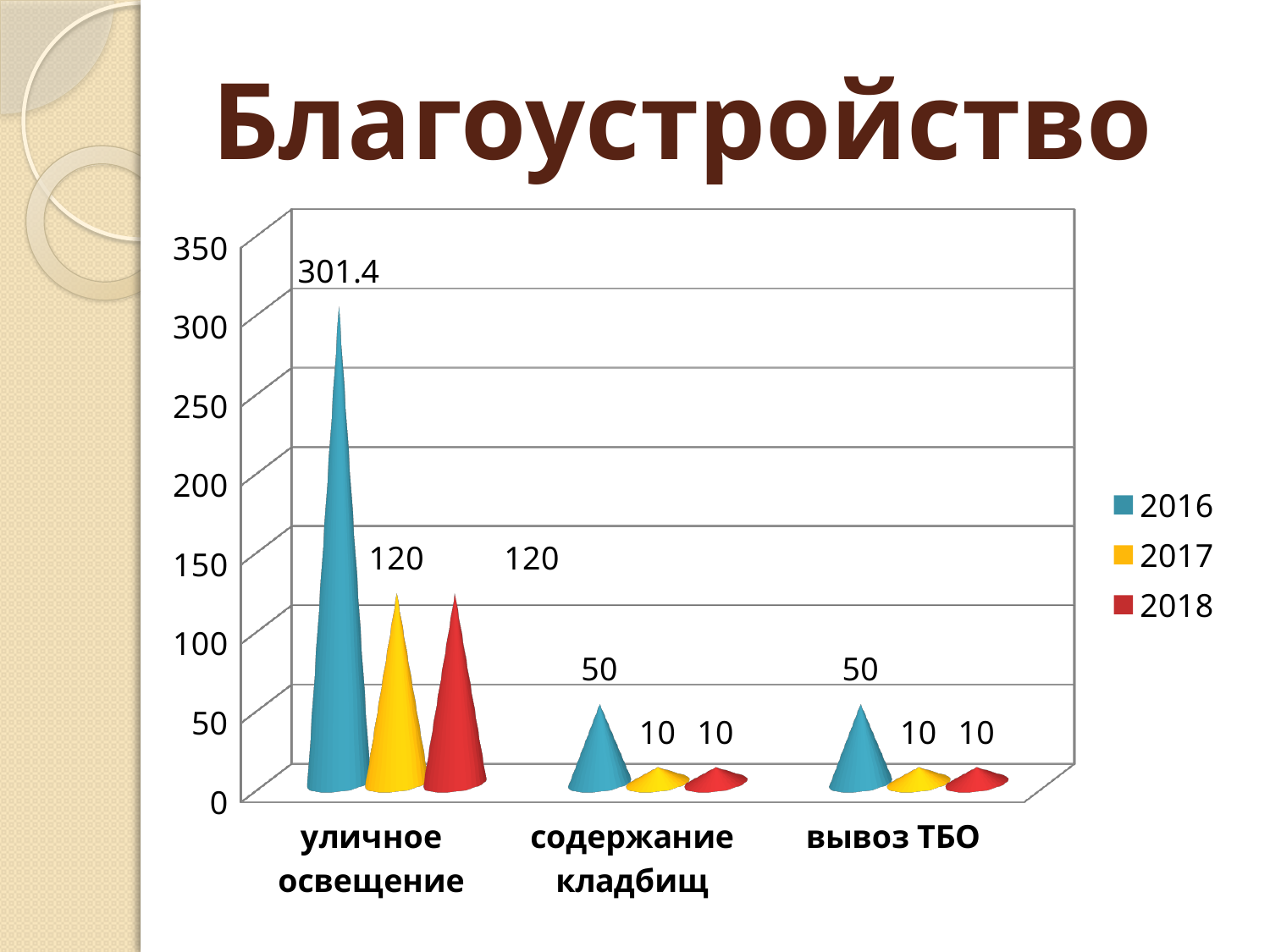
How many categories are shown on the x axis? 3 What is the value for содержание кладбищ in 2017? 10 What is the difference between the 2016 and 2018 values for вывоз ТБО? 40 Which is larger: the 2016 value for содержание кладбищ or the 2017 value for уличное освещение? 2017 value for уличное освещение Which series has the lowest value for уличное освещение? 2017 and 2018 (both 120) What is the title of the slide above the chart? Благоустройство What is the value for уличное освещение in 2018? 120 What is the value for вывоз ТБО in 2016? 50 What is the difference between the 2016 and 2017 values for уличное освещение? 181.4 What is the value for уличное освещение in 2016? 301.4 Which category has the highest value in 2016? уличное освещение How many series does the legend list? 3